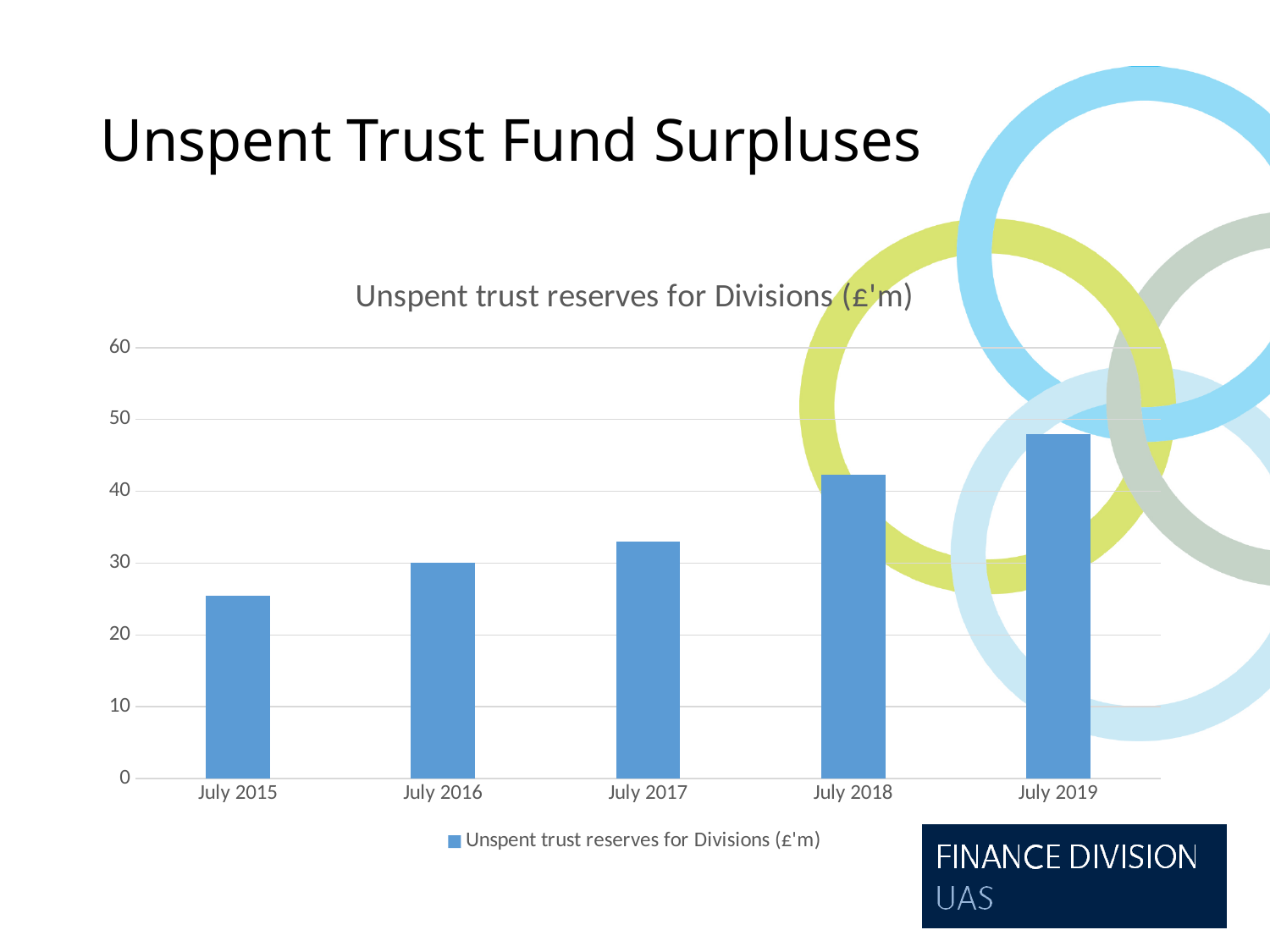
What kind of chart is shown on the slide? bar chart Which category has the highest value? July 2019 Do the values rise or fall from July 2015 to July 2019? rise What is the title of the chart? Unspent trust reserves for Divisions (£'m) Is the value for July 2018 greater or less than 50? less Which category has the lowest value? July 2015 How many categories are plotted along the x axis? 5 Is the value for July 2015 greater or less than 30? less Which is larger, the value for July 2017 or the value for July 2018? July 2018 Is the value for July 2019 greater or less than 40? greater How many series does the legend list? 1 What colour are the bars in the chart? blue